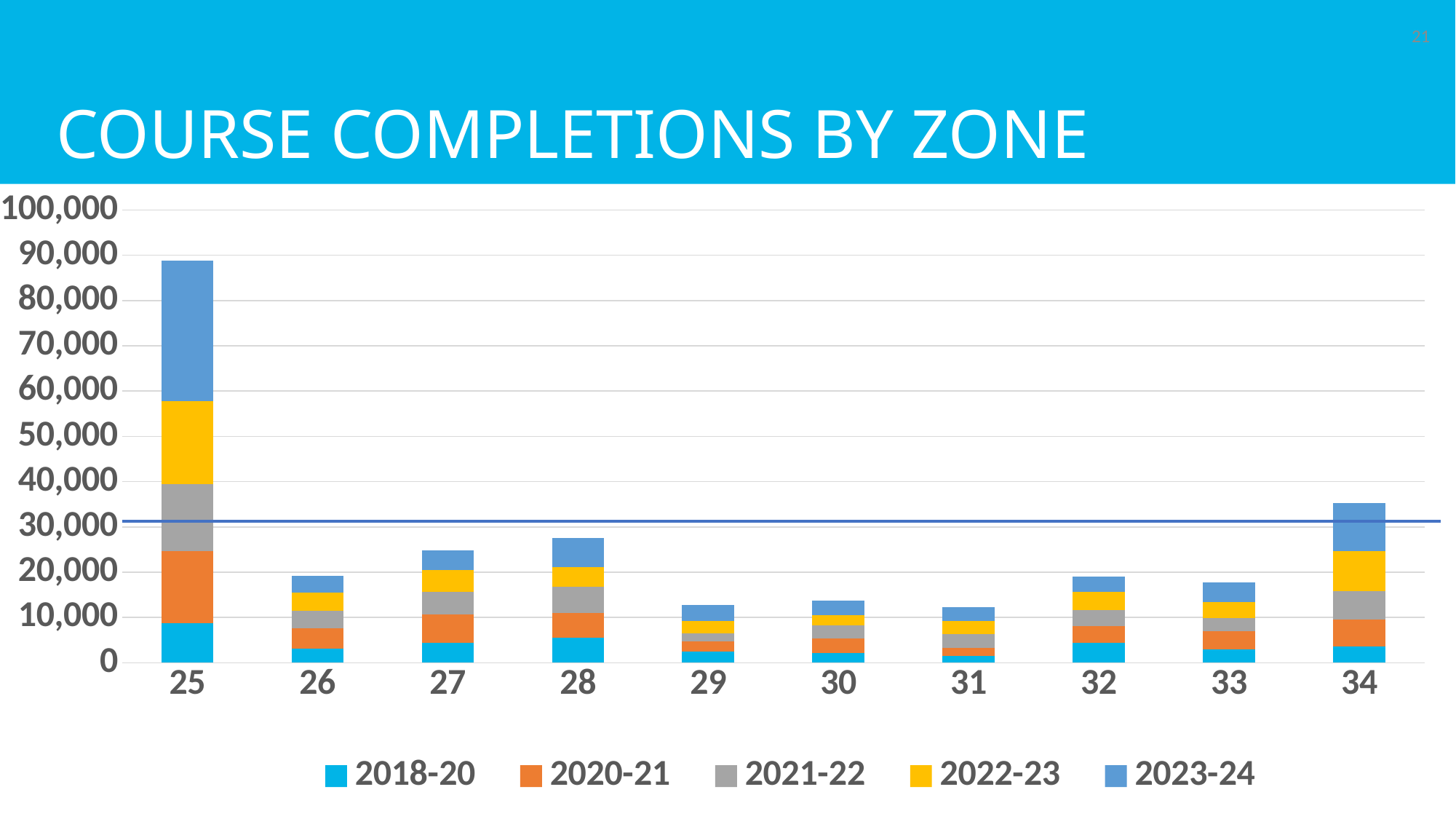
Is the total for zone 25 greater or less than 80,000? greater Is the total for zone 34 greater or less than 30,000? greater Is the total for zone 28 greater or less than 30,000? less How many zones are shown along the x axis of the chart? 10 Which zone has the highest total course completions? 25 What is the title of the chart? COURSE COMPLETIONS BY ZONE Which zone has the larger total, zone 34 or zone 28? 34 How many series does the legend list? 5 What kind of chart is shown on the slide? stacked bar chart Which series is listed first in the legend? 2018-20